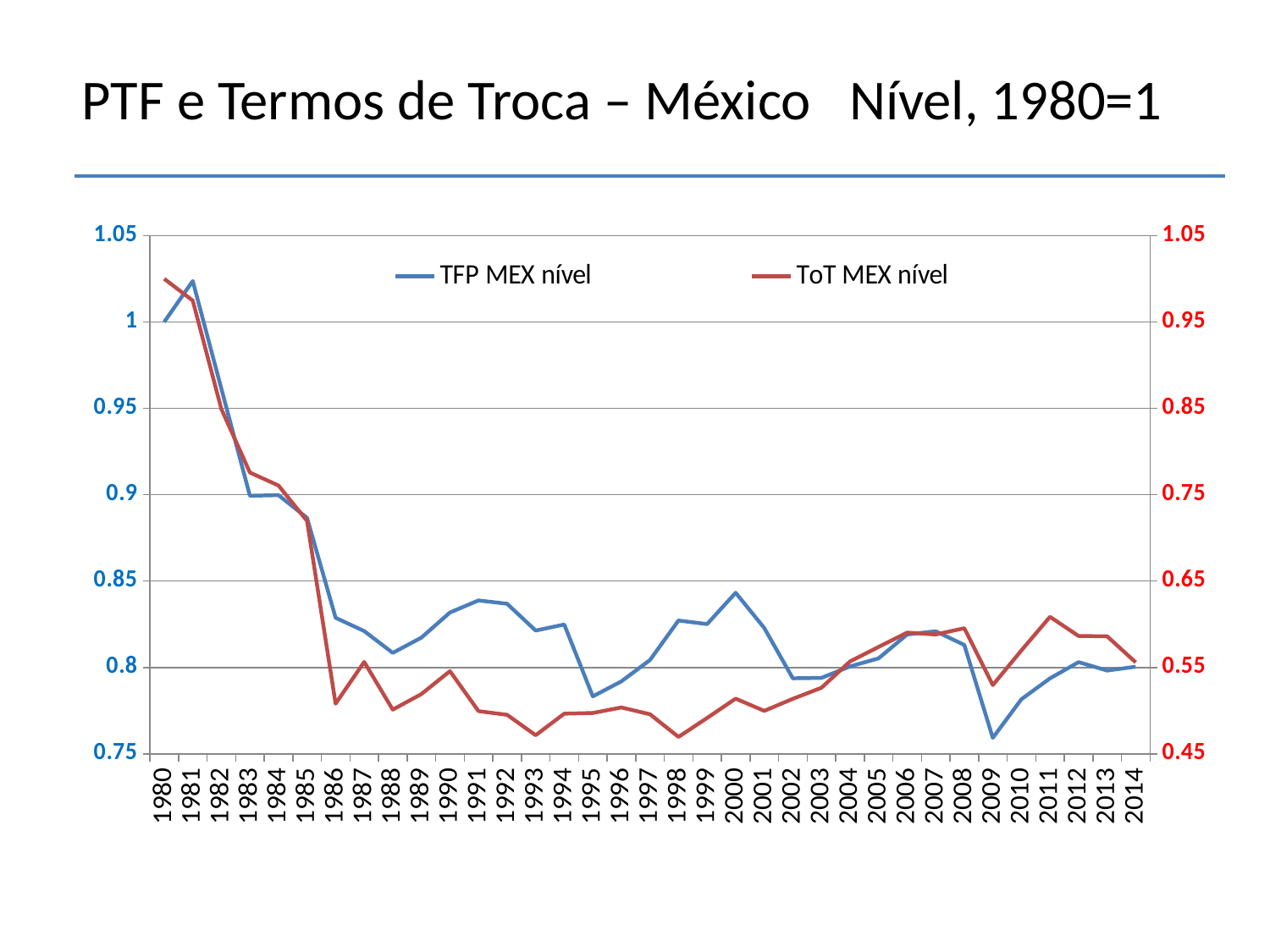
Does TFP MEX nível rise or fall between 1981 and 1986? fall Is the value of TFP MEX nível in 2000 greater or less than 0.8? greater Is the value of ToT MEX nível in 1986 greater or less than 0.55 on the right axis? less What kind of chart is shown on the slide? line chart How many years are plotted along the x axis? 35 Is the value of TFP MEX nível in 2009 greater or less than 0.8? less In which year does ToT MEX nível reach its highest value? 1980 How many series does the legend list? 2 In which year does TFP MEX nível reach its lowest value? 2009 In which year does TFP MEX nível reach its highest value? 1981 What is the value of TFP MEX nível in 1980? 1 What are the two series named in the legend? TFP MEX nível and ToT MEX nível